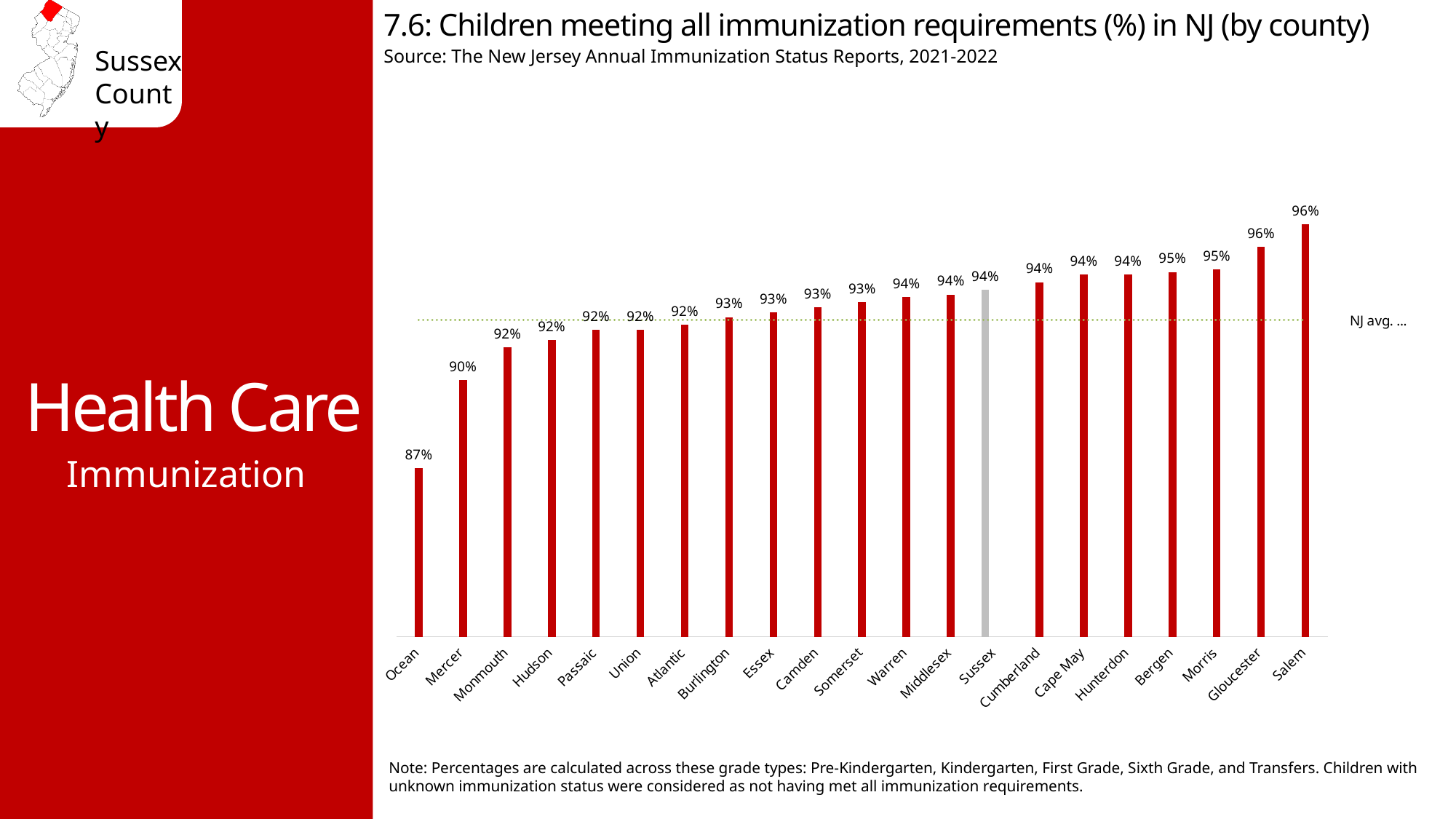
What type of chart is used on this slide? Bar chart What percentage of children in Sussex County met all immunization requirements? 94% Which has a higher value, Sussex or Salem? Salem Which county has the lowest percentage of children meeting all immunization requirements? Ocean What is the value shown for Ocean County? 87% How many counties are shown in the chart? 21 Which county has the highest percentage of children meeting all immunization requirements? Salem What is the difference in percentage points between Salem and Ocean? 9 percentage points What is the difference in percentage points between Sussex and Ocean? 7 percentage points Which has a higher value, Mercer or Ocean? Mercer What is the value shown for Mercer County? 90% Do the values generally rise or fall from left to right along the x axis? Rise